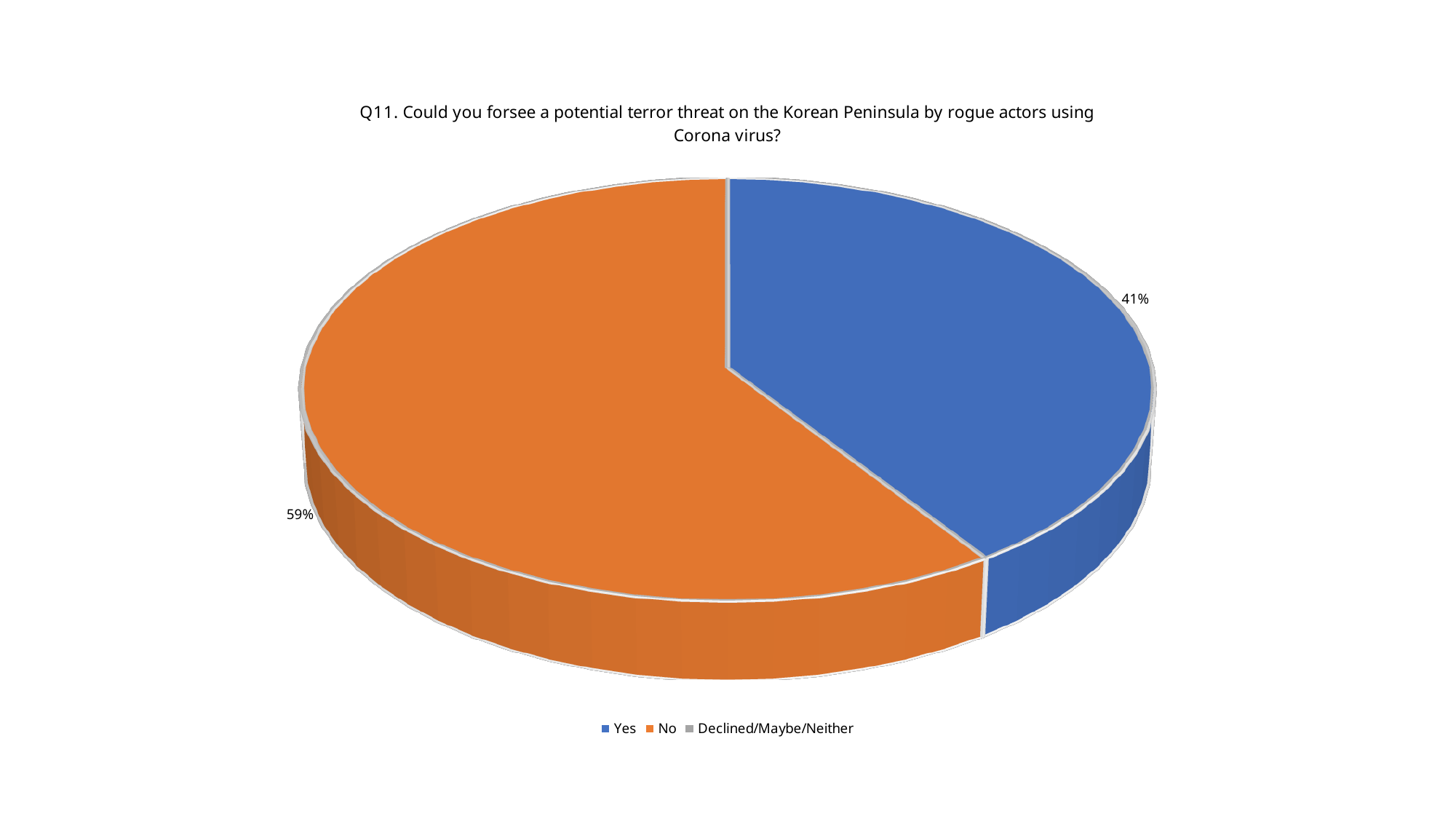
What is the third legend entry after "Yes" and "No"? Declined/Maybe/Neither Which response has the largest share of the pie? No Is the share for "Yes" greater or less than 50%? less How many entries does the legend list? 3 What percentage of respondents answered "Yes"? 41% What colour is the "No" slice? orange Is the share for "No" larger or smaller than the share for "Yes"? larger What share of the pie does the "Yes" slice represent? 41% Which of the two labelled slices is smaller, "Yes" or "No"? Yes What percentage of respondents answered "No"? 59% What is the difference in percentage points between the "No" and "Yes" slices? 18 What kind of chart is shown on the slide? pie chart